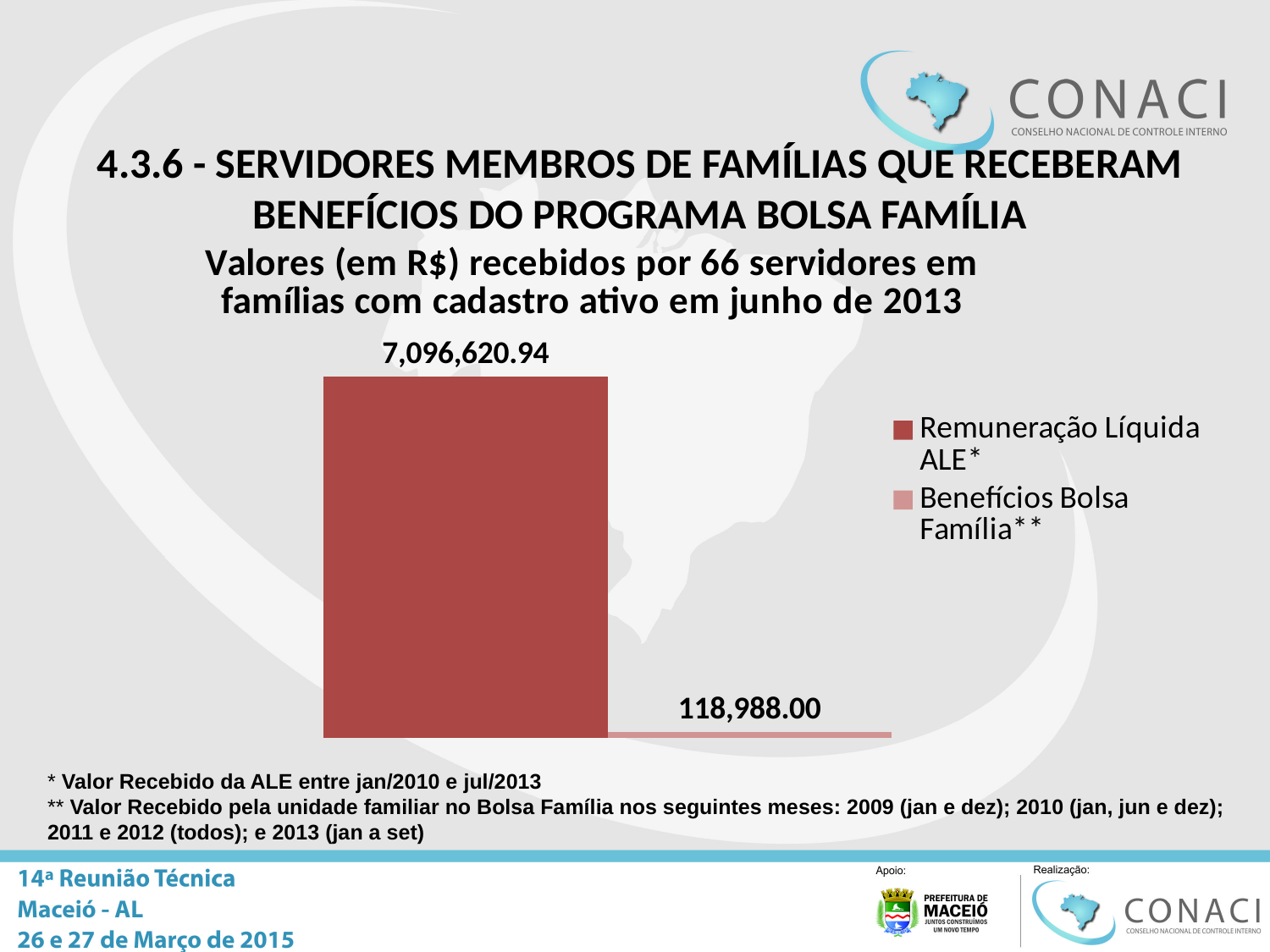
What value is shown for Benefícios Bolsa Família**? 118,988.00 What value is shown for Remuneração Líquida ALE*? 7,096,620.94 What is the title of the chart? Valores (em R$) recebidos por 66 servidores em famílias com cadastro ativo em junho de 2013 What kind of chart is shown on the slide? Bar chart What is the difference between the Remuneração Líquida ALE* value and the Benefícios Bolsa Família** value? 6,977,632.94 What colour is the bar for Remuneração Líquida ALE*? Dark red What is the total of the two values plotted in the chart? 7,215,608.94 Which series has the lowest value? Benefícios Bolsa Família** How many bars are plotted in the chart? 2 Which series has the highest value? Remuneração Líquida ALE* How many series does the legend list? 2 Which is larger: Remuneração Líquida ALE* or Benefícios Bolsa Família**? Remuneração Líquida ALE*